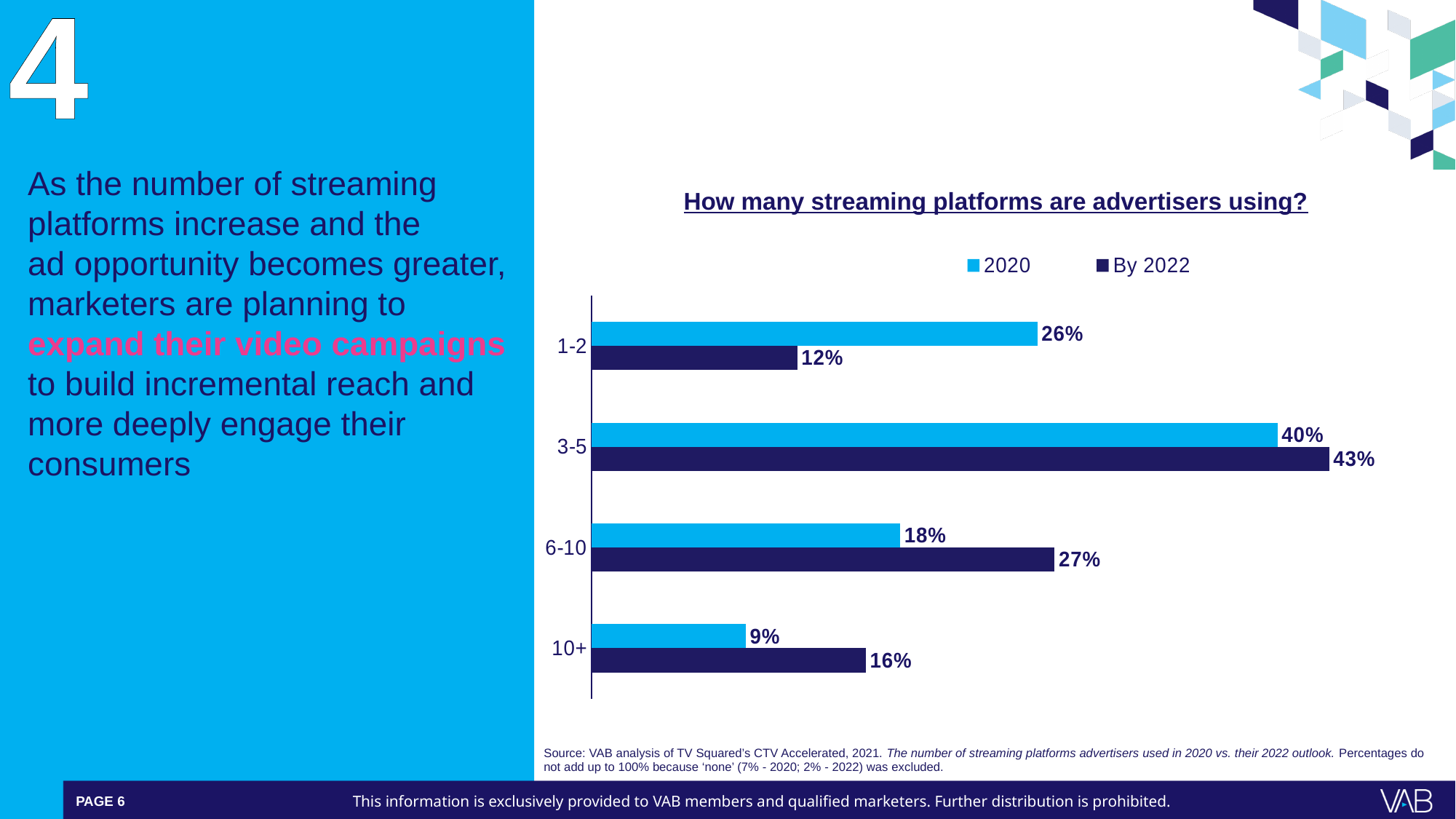
What kind of chart is shown on the slide? Bar chart Which category has the lowest By 2022 value? 1-2 What is the By 2022 value for the 10+ category? 16% What is the difference between the By 2022 and 2020 values for the 6-10 category? 9% Which is larger for the 1-2 category, the 2020 value or the By 2022 value? 2020 How many series does the legend list? 2 What is the title of the chart? How many streaming platforms are advertisers using? What is the difference between the 2020 values for the 3-5 and 10+ categories? 31% How many categories are shown on the chart? 4 Which category has the highest 2020 value? 3-5 What is the 2020 value for the 1-2 category? 26% What is the By 2022 value for the 3-5 category? 43%